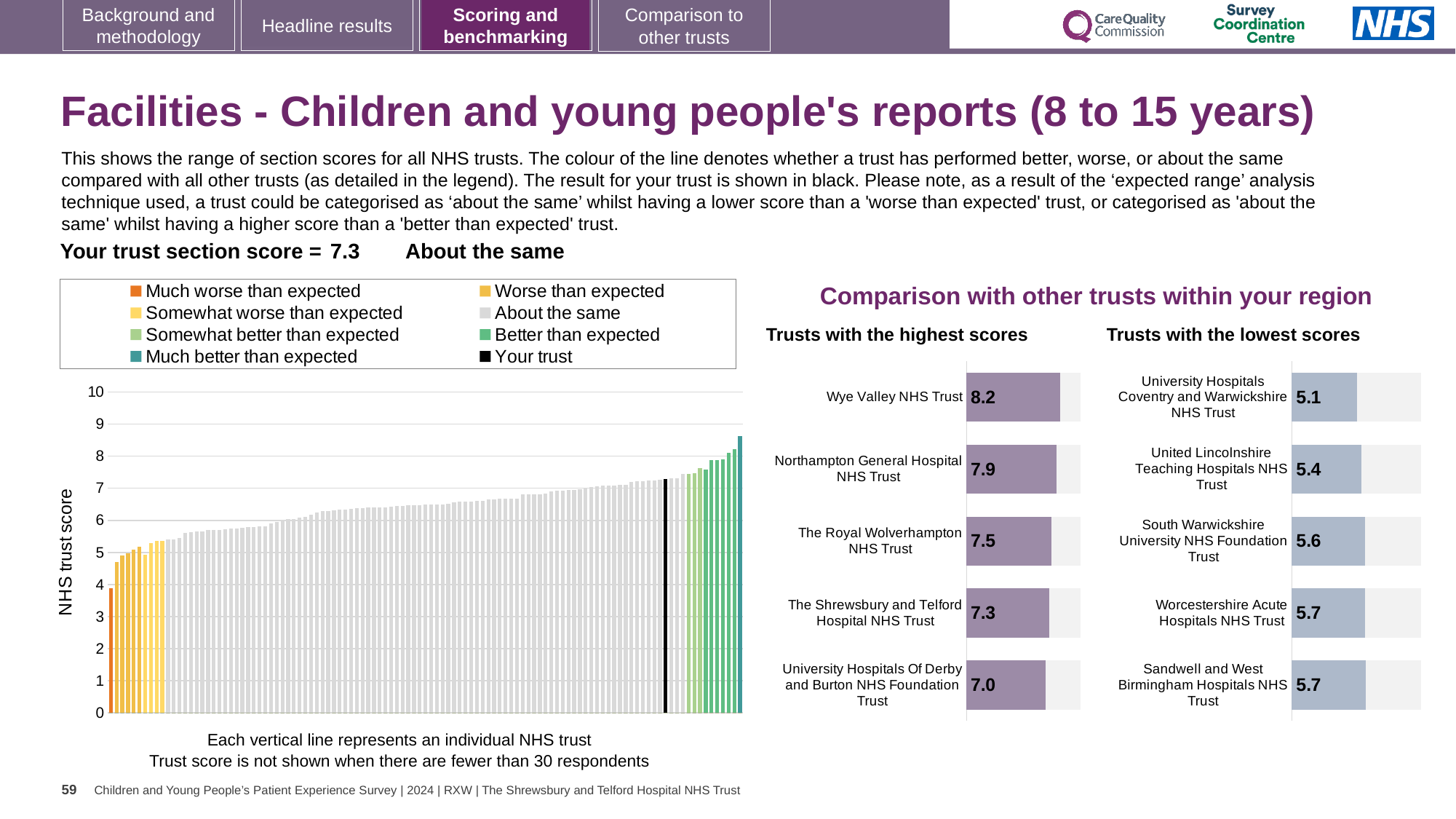
In the 'Trusts with the lowest scores' chart, which trust has the lowest score? University Hospitals Coventry and Warwickshire NHS Trust In the main NHS trust score chart on the left, what is the section score for your trust (the black bar)? 7.3 In the 'Trusts with the highest scores' chart, what is the difference between the scores of Wye Valley NHS Trust and University Hospitals Of Derby and Burton NHS Foundation Trust? 1.2 In the 'Trusts with the highest scores' chart, which has the higher score: The Royal Wolverhampton NHS Trust or The Shrewsbury and Telford Hospital NHS Trust? The Royal Wolverhampton NHS Trust In the main NHS trust score chart on the left, do the bar values rise or fall from left to right? rise In the main NHS trust score chart on the left, is the value of the tallest bar greater or less than 8? greater How many entries does the legend of the main NHS trust score chart list? 8 How many trusts are listed in the 'Trusts with the lowest scores' chart? 5 In the 'Trusts with the lowest scores' chart, what is the score for South Warwickshire University NHS Foundation Trust? 5.6 In the 'Trusts with the lowest scores' chart, what is the score for United Lincolnshire Teaching Hospitals NHS Trust? 5.4 In the 'Trusts with the highest scores' chart, what is the score for Northampton General Hospital NHS Trust? 7.9 In the 'Trusts with the highest scores' chart, what is the score for Wye Valley NHS Trust? 8.2